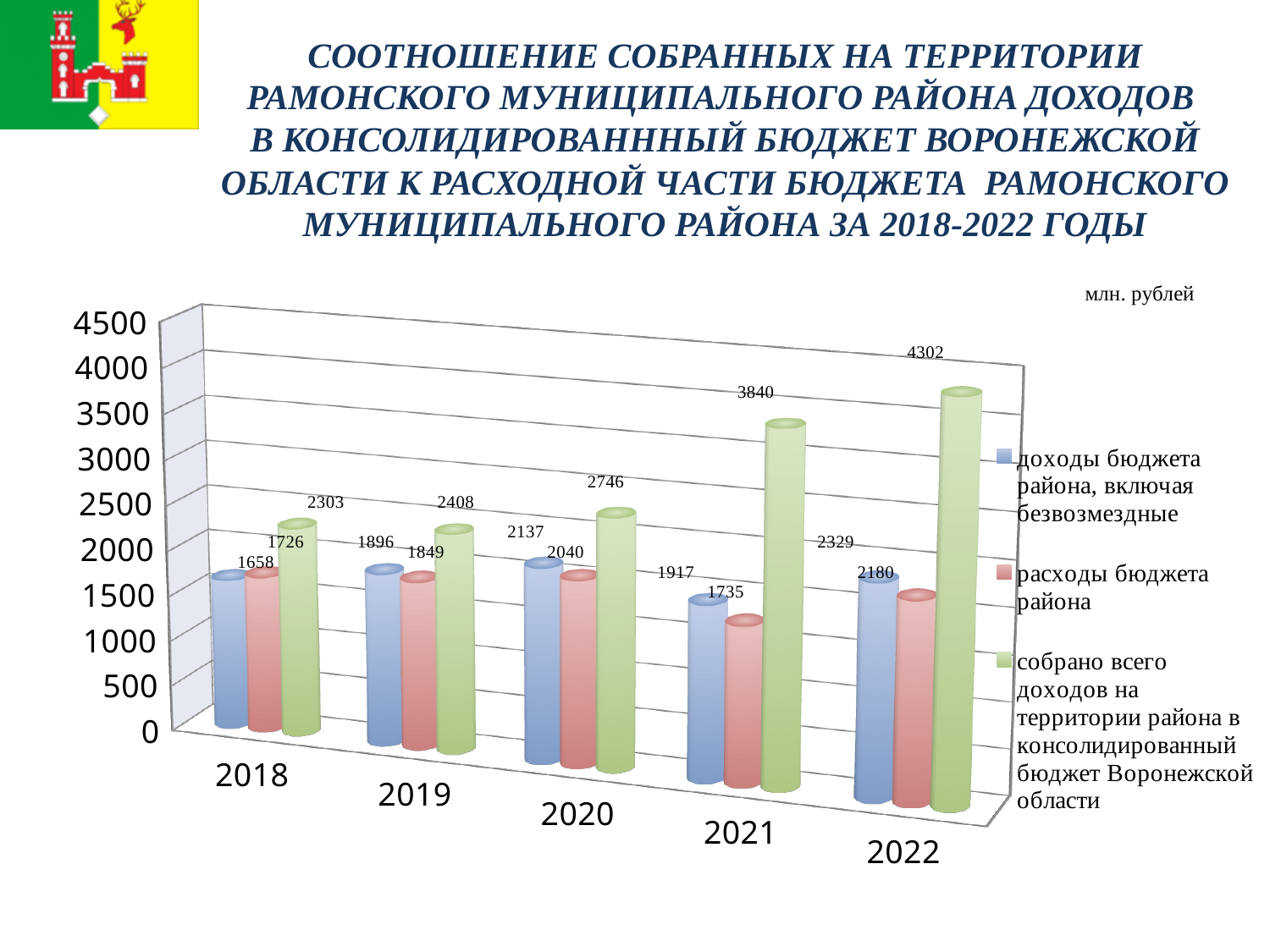
Which is larger in 2019: 'доходы бюджета района, включая безвозмездные' or 'расходы бюджета района'? доходы бюджета района, включая безвозмездные Is the value of 'собрано всего доходов' for 2020 greater or less than 2500? greater What is the value of 'доходы бюджета района, включая безвозмездные' for 2021? 1917 Does 'собрано всего доходов на территории района в консолидированный бюджет Воронежской области' rise or fall from 2018 to 2022? rise In which year is 'доходы бюджета района, включая безвозмездные' lowest? 2018 What is the value of 'собрано всего доходов на территории района в консолидированный бюджет Воронежской области' for 2022? 4302 What kind of chart is shown on the slide? bar chart In which year is 'собрано всего доходов на территории района в консолидированный бюджет Воронежской области' highest? 2022 How many series does the legend list? 3 How many years are shown on the x axis? 5 What is the value of 'расходы бюджета района' for 2020? 2040 What is the difference between 'собрано всего доходов' and 'расходы бюджета района' in 2021? 2105